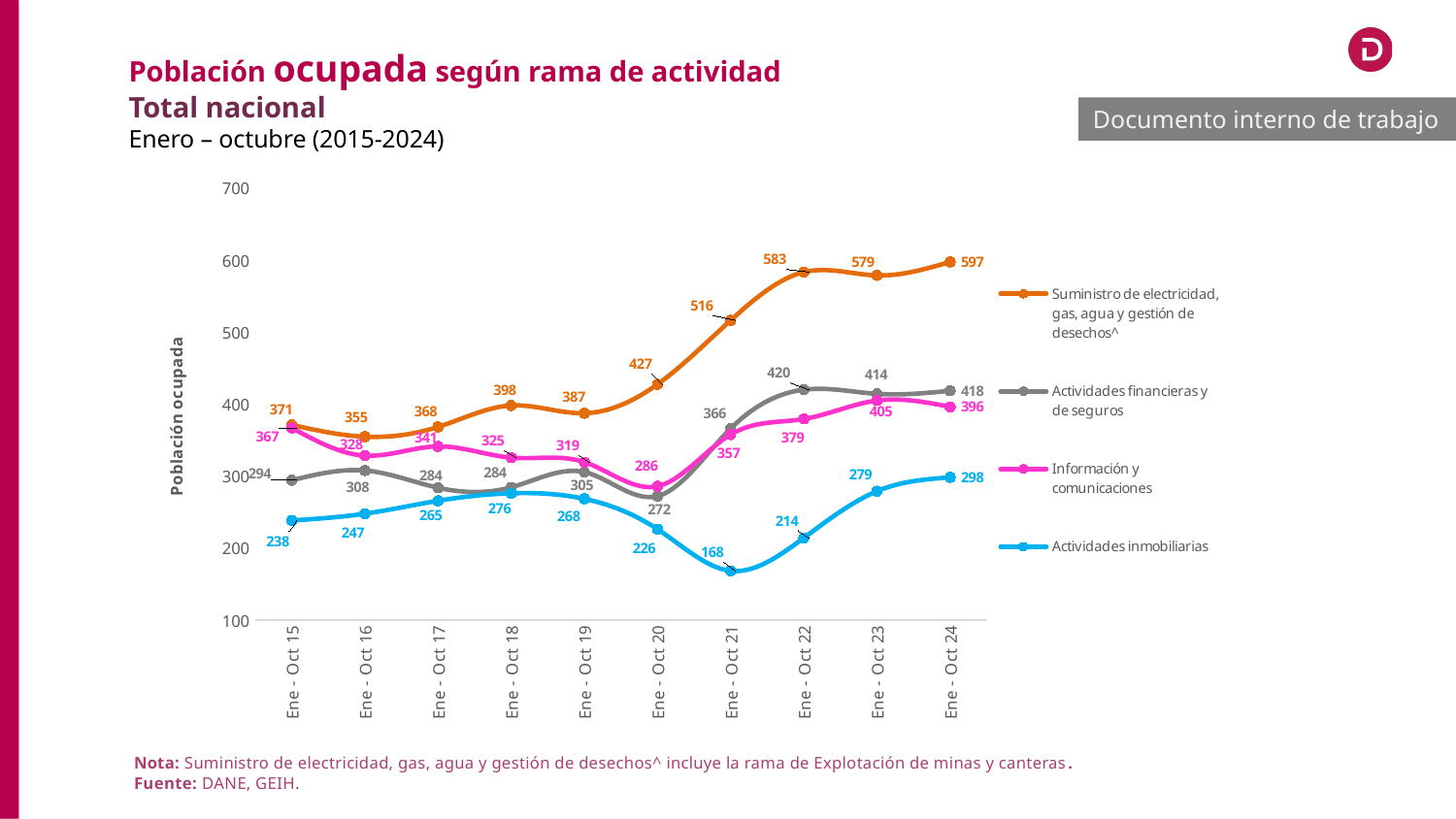
In which period does Actividades inmobiliarias reach its lowest value? Ene - Oct 21 What is the label of the y axis? Población ocupada Which is larger in Ene - Oct 15: Información y comunicaciones or Actividades financieras y de seguros? Información y comunicaciones In which period does Suministro de electricidad, gas, agua y gestión de desechos^ reach its highest value? Ene - Oct 24 What is the value for Suministro de electricidad, gas, agua y gestión de desechos^ in Ene - Oct 24? 597 What is the value for Información y comunicaciones in Ene - Oct 23? 405 What type of chart is shown on the slide? line chart What is the difference between Suministro de electricidad, gas, agua y gestión de desechos^ and Actividades inmobiliarias in Ene - Oct 24? 299 How many series does the legend list? 4 What is the value for Actividades inmobiliarias in Ene - Oct 21? 168 What is the value for Actividades financieras y de seguros in Ene - Oct 22? 420 How many time periods are shown on the x axis? 10